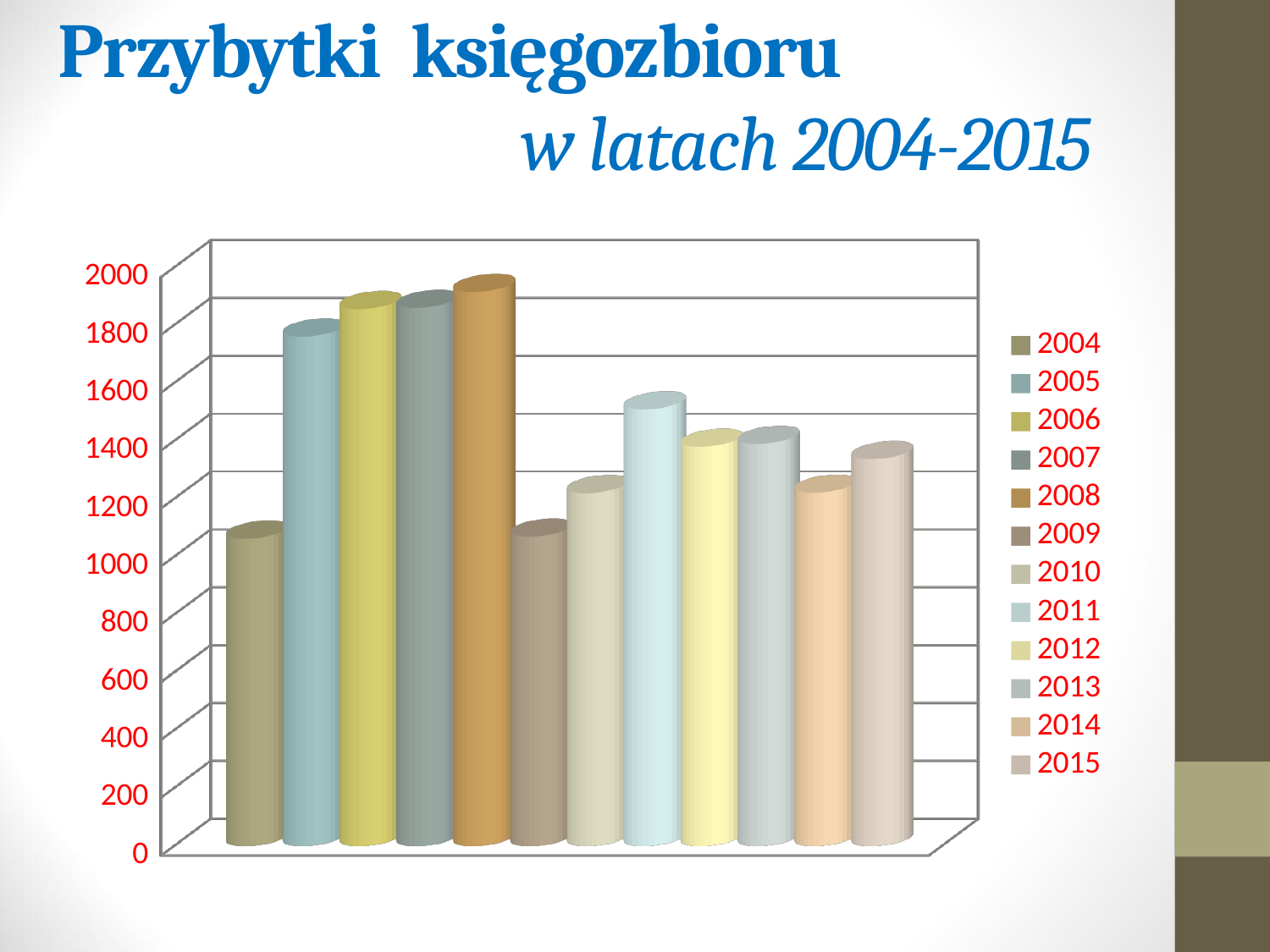
How many entries does the legend list? 12 How many bars are plotted in the chart? 12 Do the values rise or fall from 2004 to 2008? rise Which year has the highest value in the chart? 2008 Is the value for 2010 greater or less than 1400? less Is the value for 2008 greater or less than 1800? greater Which is larger, the value for 2011 or the value for 2010? 2011 Which is larger, the value for 2005 or the value for 2004? 2005 Is the value for 2009 greater or less than 1200? less What kind of chart is shown on the slide? bar chart